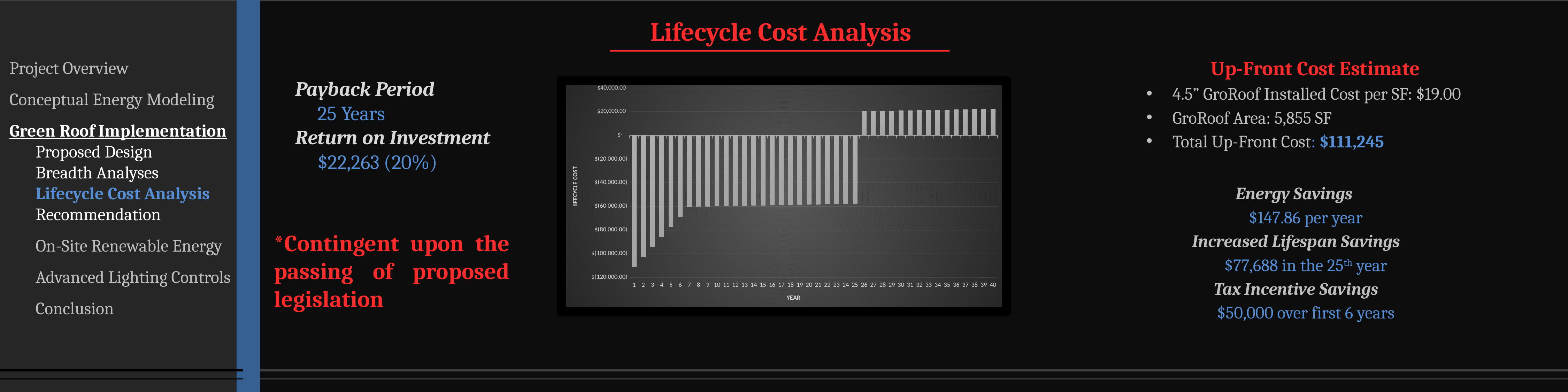
What kind of chart is shown on the slide? bar chart Which has the larger value, year 1 or year 20? year 20 How many years are plotted along the x axis of the chart? 40 Which year has the lowest lifecycle cost value in the chart? 1 What is the label of the y axis of the chart? LIFECYCLE COST Is the value for year 10 greater or less than $(40,000.00)? less Is the value for year 1 greater or less than $(100,000.00)? less Is the value for year 30 greater or less than $-? greater Which has the larger value, year 10 or year 35? year 35 What is the label of the x axis of the chart? YEAR Do the values rise or fall from year 1 to year 25? rise